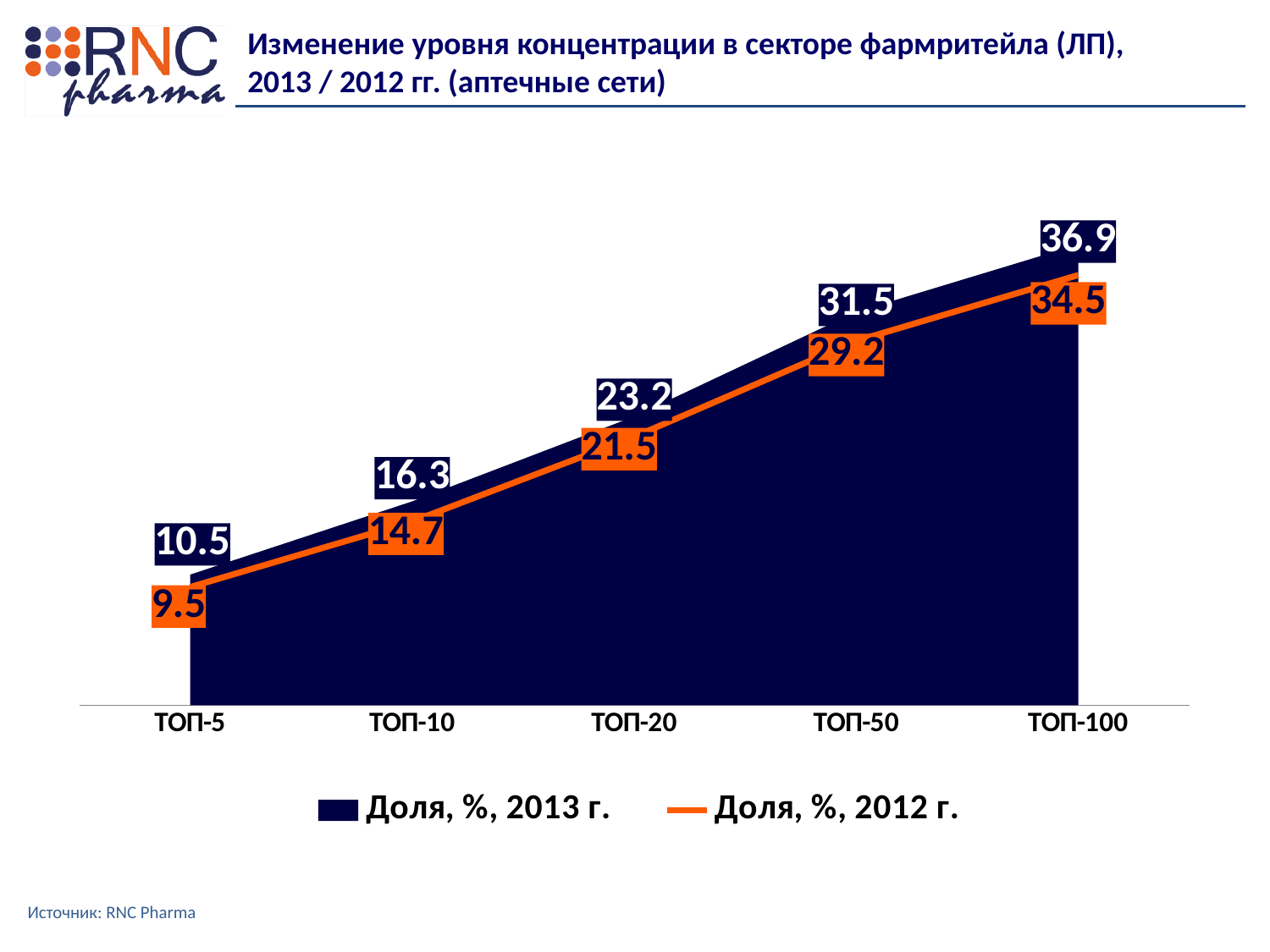
How many series does the legend list? 2 What is the value of Доля, %, 2012 г. for ТОП-50? 29.2 Do the values for Доля, %, 2012 г. rise or fall from ТОП-5 to ТОП-100? rise What is the difference between the 2013 and 2012 values for ТОП-10? 1.6 What is the value of Доля, %, 2012 г. for ТОП-100? 34.5 Which category has the lowest value for Доля, %, 2012 г.? ТОП-5 What is the difference between the 2013 and 2012 values for ТОП-100? 2.4 Which is larger for ТОП-50: the value for Доля, %, 2013 г. or Доля, %, 2012 г.? Доля, %, 2013 г. Which category has the highest value for Доля, %, 2013 г.? ТОП-100 How many categories are shown on the x axis? 5 What is the value of Доля, %, 2013 г. for ТОП-5? 10.5 What is the value of Доля, %, 2013 г. for ТОП-20? 23.2